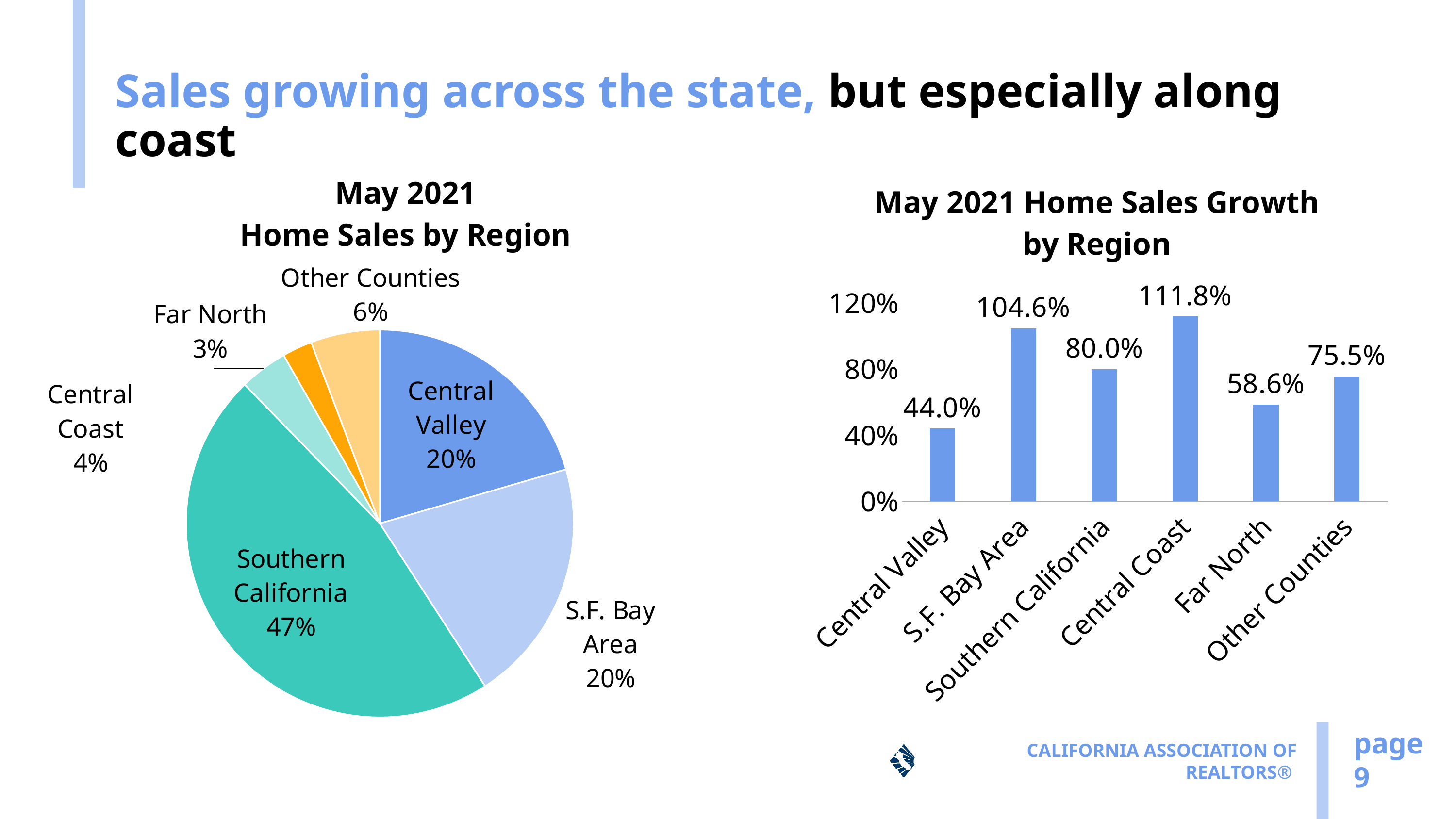
In the 'May 2021 Home Sales by Region' pie chart, which region has the smallest share? Far North In the 'May 2021 Home Sales Growth by Region' chart, which is larger, Southern California or Other Counties? Southern California In the 'May 2021 Home Sales by Region' pie chart, which region has the largest share? Southern California What kind of chart is 'May 2021 Home Sales by Region'? Pie chart In the 'May 2021 Home Sales by Region' pie chart, what share of home sales does Southern California account for? 47% In the 'May 2021 Home Sales Growth by Region' chart, what is the difference between S.F. Bay Area and Far North? 46.0% In the 'May 2021 Home Sales by Region' pie chart, what is the share for Other Counties? 6% In the 'May 2021 Home Sales Growth by Region' chart, what is the value for Central Coast? 111.8% In the 'May 2021 Home Sales by Region' pie chart, how many regions are shown? 6 In the 'May 2021 Home Sales Growth by Region' chart, which region has the highest growth? Central Coast What kind of chart is 'May 2021 Home Sales Growth by Region'? Bar chart In the 'May 2021 Home Sales Growth by Region' chart, which region has the lowest growth? Central Valley